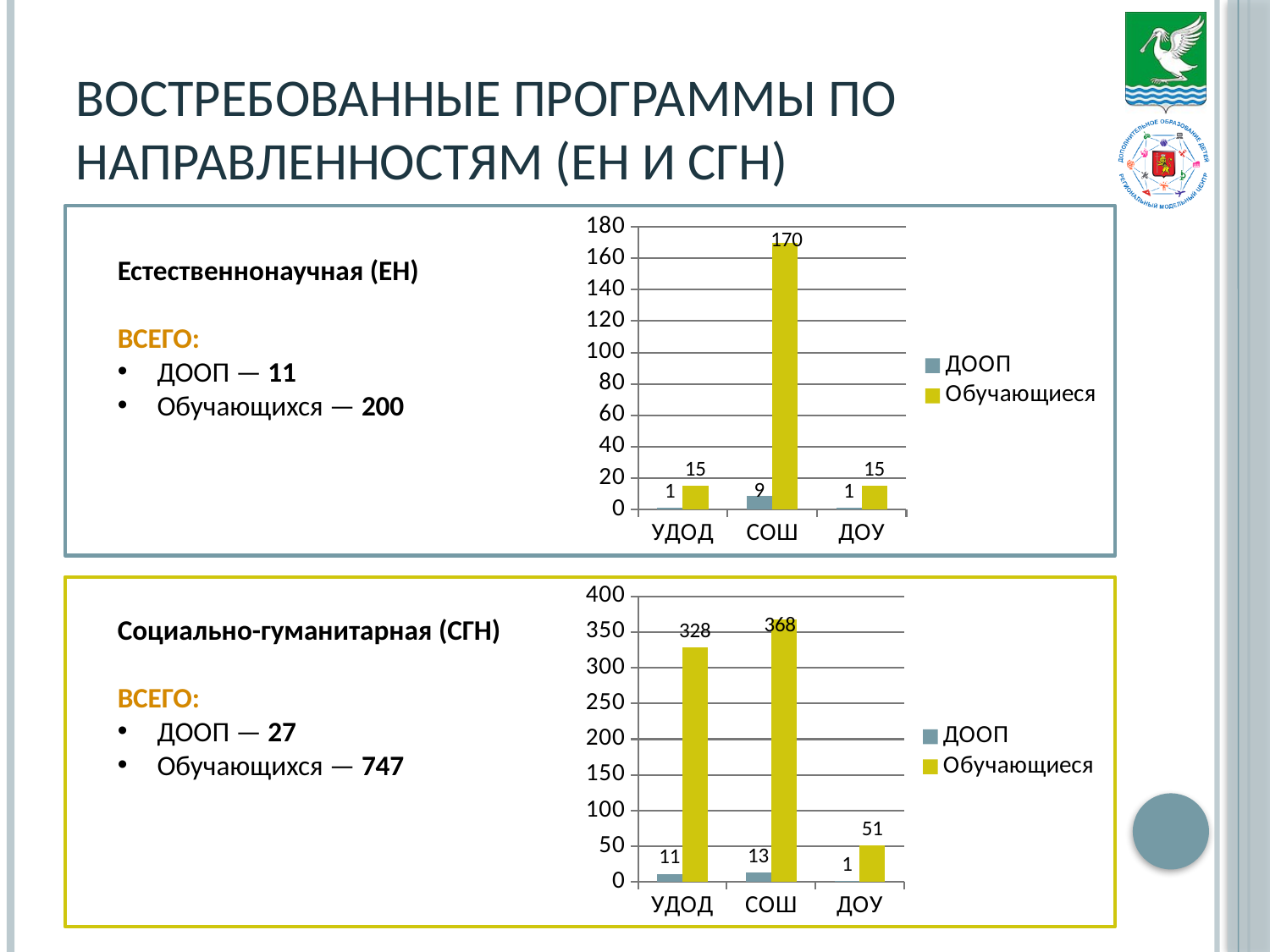
In the top chart (Естественнонаучная), how many series does the legend list? 2 In the top chart (Естественнонаучная), what is the value of Обучающиеся for СОШ? 170 What type of chart is the top chart (Естественнонаучная)? Bar chart In the bottom chart (Социально-гуманитарная), which is larger: Обучающиеся for СОШ or for УДОД? СОШ In the top chart (Естественнонаучная), which category has the highest value for Обучающиеся? СОШ In the top chart (Естественнонаучная), what is the difference between Обучающиеся for СОШ and for УДОД? 155 In the bottom chart (Социально-гуманитарная), what is the value of Обучающиеся for УДОД? 328 In the bottom chart (Социально-гуманитарная), what is the value of ДООП for ДОУ? 1 In the bottom chart (Социально-гуманитарная), what is the difference between Обучающиеся for СОШ and for ДОУ? 317 In the top chart (Естественнонаучная), what is the value of ДООП for СОШ? 9 In the bottom chart (Социально-гуманитарная), which category has the lowest value for Обучающиеся? ДОУ How many categories are shown on the x axis of the bottom chart (Социально-гуманитарная)? 3